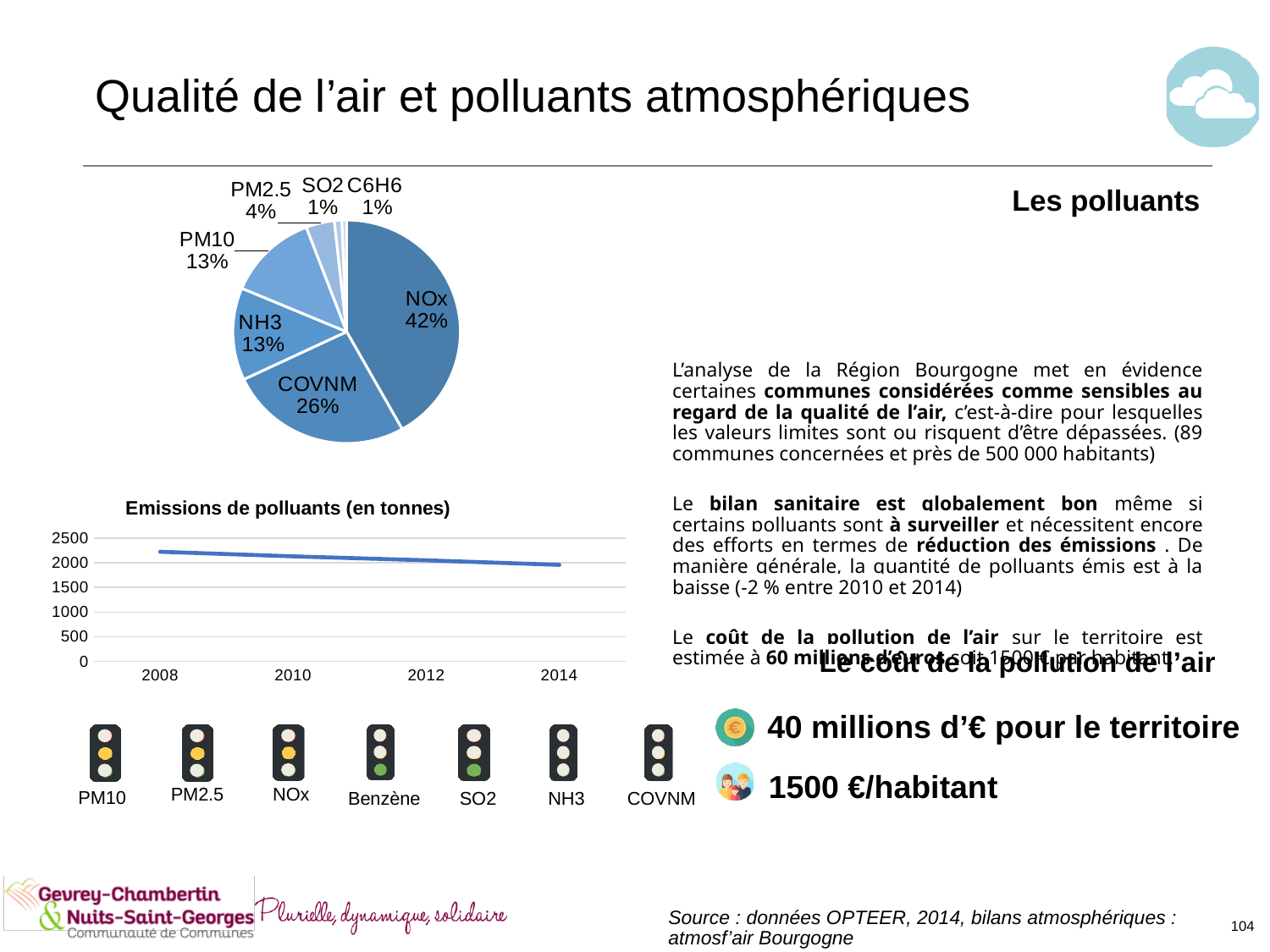
In the pie chart, how many slices are there? 7 In the pie chart, which pollutant has the largest share? NOx In the chart 'Emissions de polluants (en tonnes)', do the values rise or fall from 2008 to 2014? fall In the pie chart, what share does NOx have? 42% In the pie chart, what share does COVNM have? 26% In the pie chart, which is larger, the share of NH3 or the share of PM2.5? NH3 In the chart 'Emissions de polluants (en tonnes)', how many years are shown on the x axis? 4 What kind of chart is the chart at the top left of the slide? pie chart In the pie chart, what is the difference between the NOx share and the COVNM share? 16 percentage points In the pie chart, what share does PM2.5 have? 4% What is the title of the chart at the bottom left of the slide? Emissions de polluants (en tonnes) In the chart 'Emissions de polluants (en tonnes)', is the value for 2008 greater or less than 2000? greater